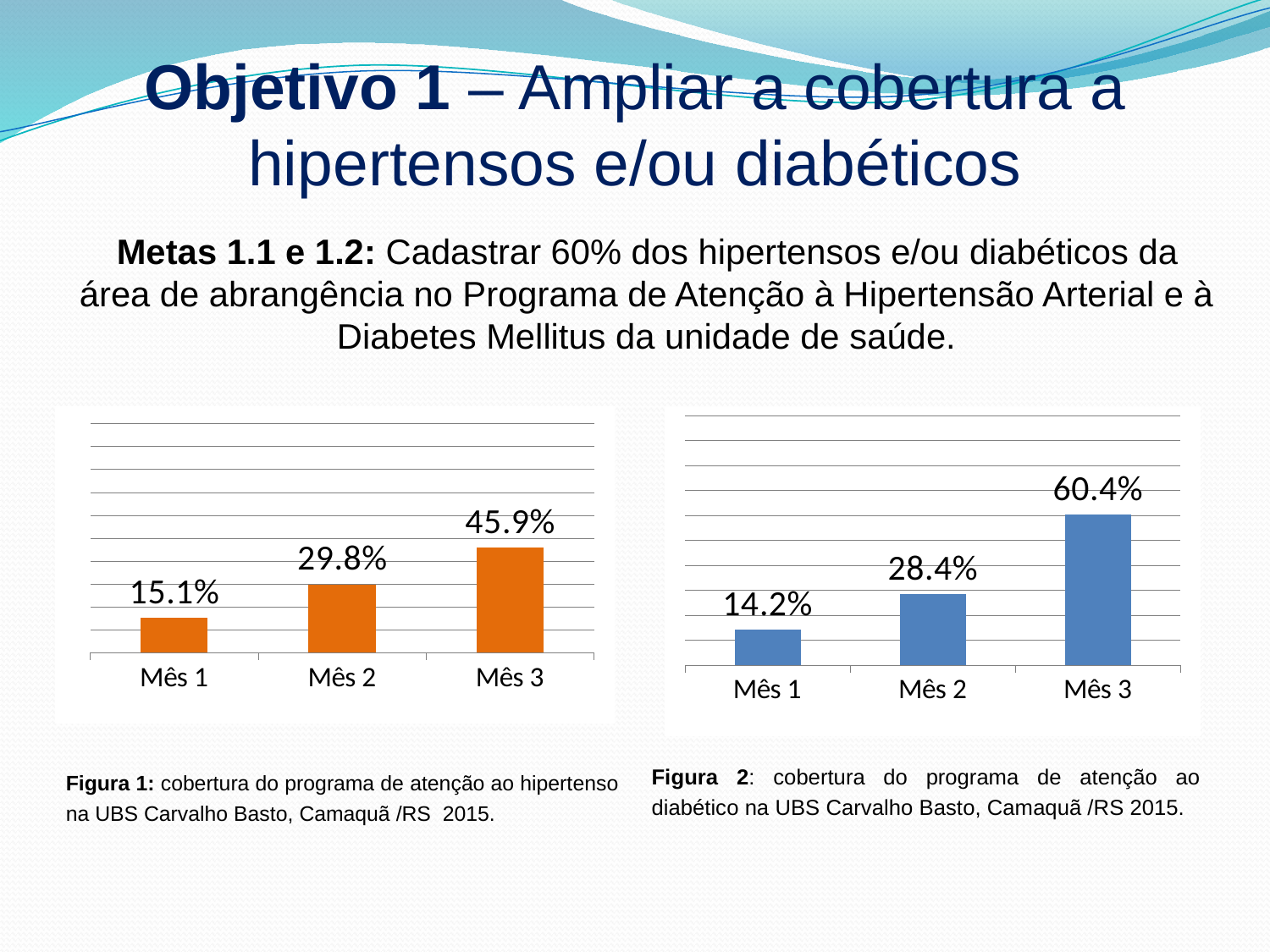
In the left chart (Figura 1), what is the value for Mês 1? 15.1% In the right chart (Figura 2, diabetes coverage), what is the value for Mês 3? 60.4% In the left chart (Figura 1), do the values rise or fall from Mês 1 to Mês 3? Rise In the right chart (Figura 2), what is the difference between the values for Mês 3 and Mês 2? 32.0% In the left chart (Figura 1, hypertension coverage), what is the value for Mês 2? 29.8% In the left chart (Figura 1), what is the difference between the values for Mês 3 and Mês 1? 30.8% What kind of chart is the right chart (Figura 2)? Bar chart In the left chart (Figura 1), which month has the lowest value? Mês 1 Which is larger: the Mês 3 value in the left chart (Figura 1) or the Mês 3 value in the right chart (Figura 2)? Right chart (Figura 2), 60.4% How many categories (months) are shown in the left chart (Figura 1)? 3 In the right chart (Figura 2), what is the value for Mês 1? 14.2% In the right chart (Figura 2), which month has the highest value? Mês 3